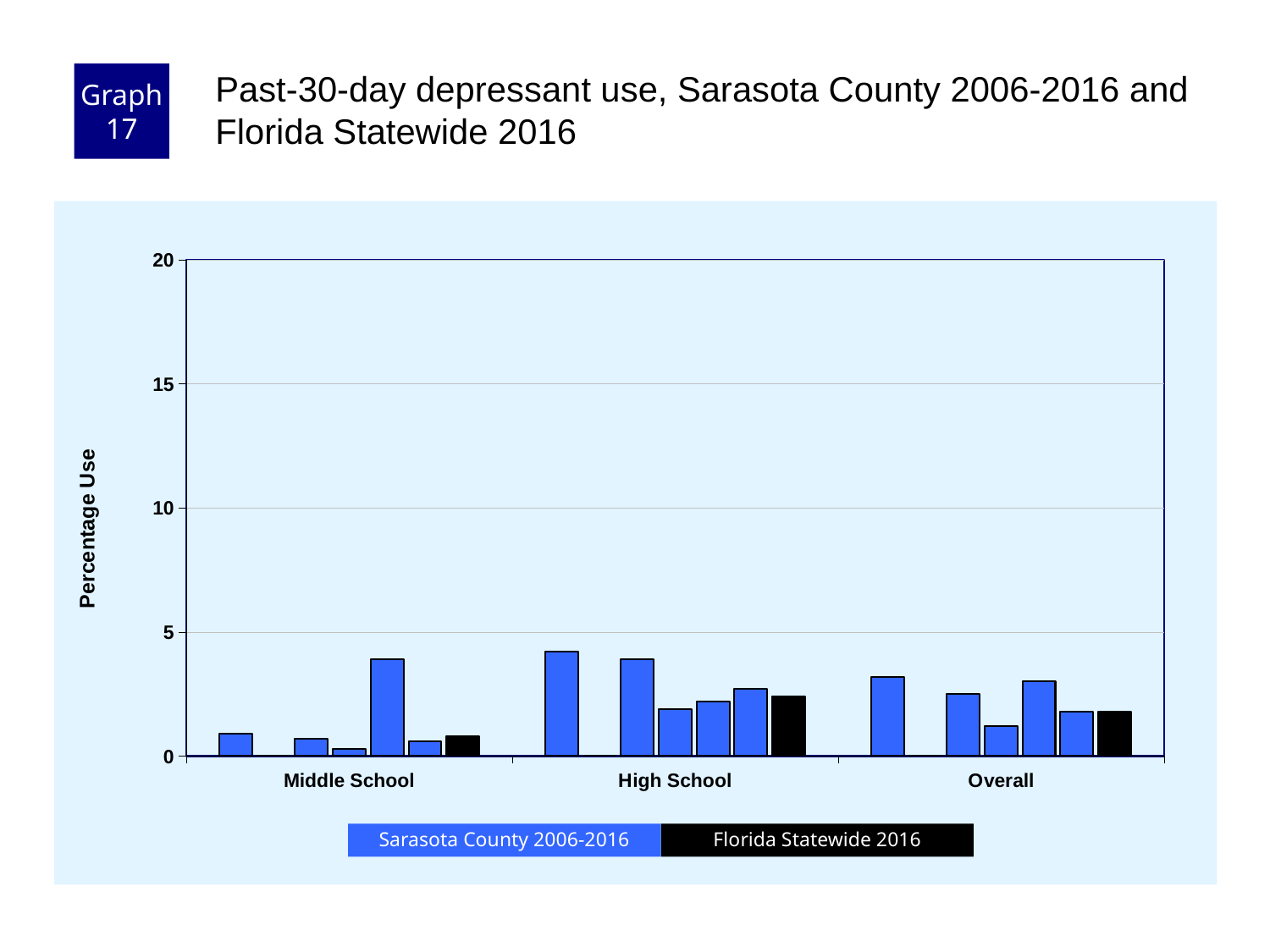
Which is larger, the Florida Statewide 2016 value for Overall or for Middle School? Overall Is the Florida Statewide 2016 value for High School greater or less than 5? less Is the tallest Sarasota County 2006-2016 bar in the High School group greater or less than 5? less What kind of chart is shown on the slide? bar chart How many category groups are shown along the x axis? 3 Which category group contains the tallest bar on the chart? High School Which is larger, the Florida Statewide 2016 value for High School or for Middle School? High School Which colour represents Florida Statewide 2016 in the legend? black Is the Florida Statewide 2016 value for Middle School greater or less than 5? less What is the label on the y axis? Percentage Use Which category group has the lowest Florida Statewide 2016 value? Middle School How many series does the legend list? 2